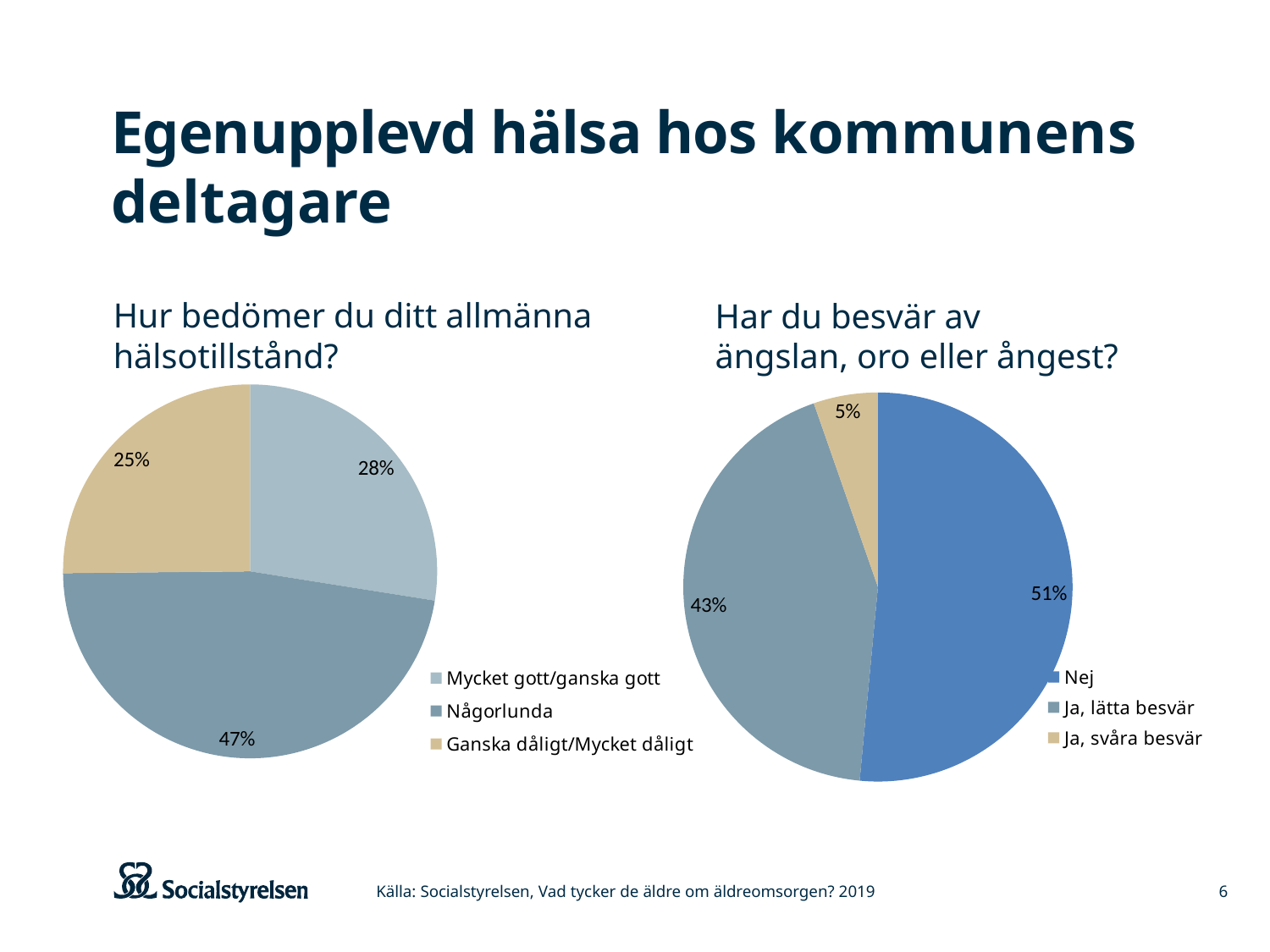
In the left chart 'Hur bedömer du ditt allmänna hälsotillstånd?', what share is labelled for Någorlunda? 47% What type of chart is used for 'Har du besvär av ängslan, oro eller ångest?'? Pie chart In the left chart 'Hur bedömer du ditt allmänna hälsotillstånd?', which category has the smallest slice? Ganska dåligt/Mycket dåligt In the left chart 'Hur bedömer du ditt allmänna hälsotillstånd?', which category has the largest slice? Någorlunda In the right chart 'Har du besvär av ängslan, oro eller ångest?', what is the difference in percentage points between Ja, lätta besvär and Ja, svåra besvär? 38 percentage points How many categories does the legend of the left chart 'Hur bedömer du ditt allmänna hälsotillstånd?' list? 3 In the right chart 'Har du besvär av ängslan, oro eller ångest?', what share is labelled for Ja, svåra besvär? 5% In the right chart 'Har du besvär av ängslan, oro eller ångest?', which is larger: Nej or Ja, lätta besvär? Nej In the right chart 'Har du besvär av ängslan, oro eller ångest?', which category has the smallest slice? Ja, svåra besvär In the right chart 'Har du besvär av ängslan, oro eller ångest?', what share is labelled for Nej? 51% In the left chart 'Hur bedömer du ditt allmänna hälsotillstånd?', what is the difference in percentage points between Någorlunda and Ganska dåligt/Mycket dåligt? 22 percentage points In the left chart 'Hur bedömer du ditt allmänna hälsotillstånd?', what share is labelled for Mycket gott/ganska gott? 28%